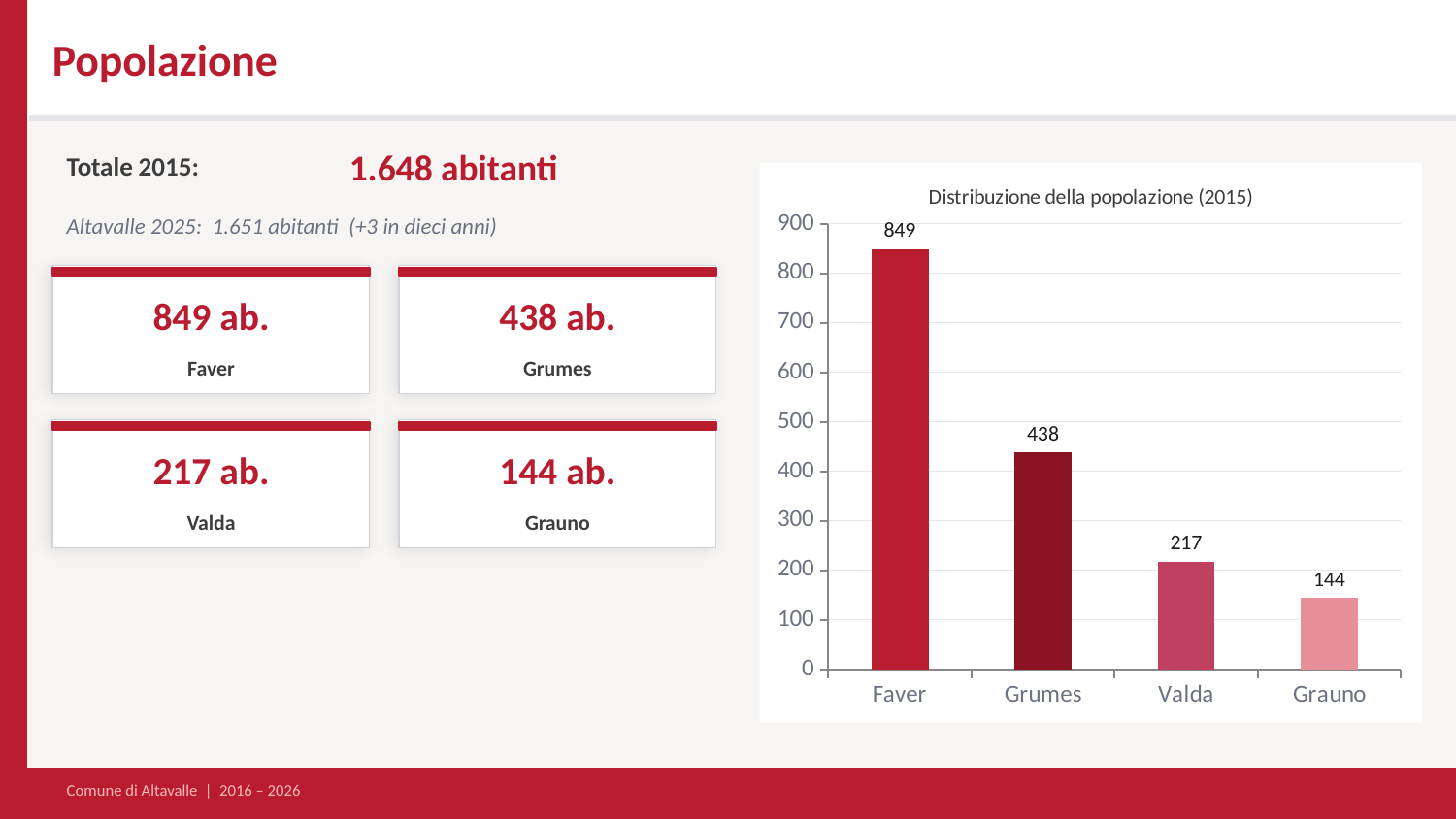
What is the value for Grumes in the chart? 438 What is the value for Grauno in the chart? 144 What is the value for Faver in the chart? 849 What is the difference between the values for Faver and Grumes? 411 Which category has the highest value in the chart? Faver What is the difference between the values for Valda and Grauno? 73 Which category has the lowest value in the chart? Grauno What is the title of the chart? Distribuzione della popolazione (2015) What kind of chart is shown on the slide? Bar chart What is the value for Valda in the chart? 217 How many categories are shown in the chart? 4 Which is larger, the value for Grumes or the value for Valda? Grumes